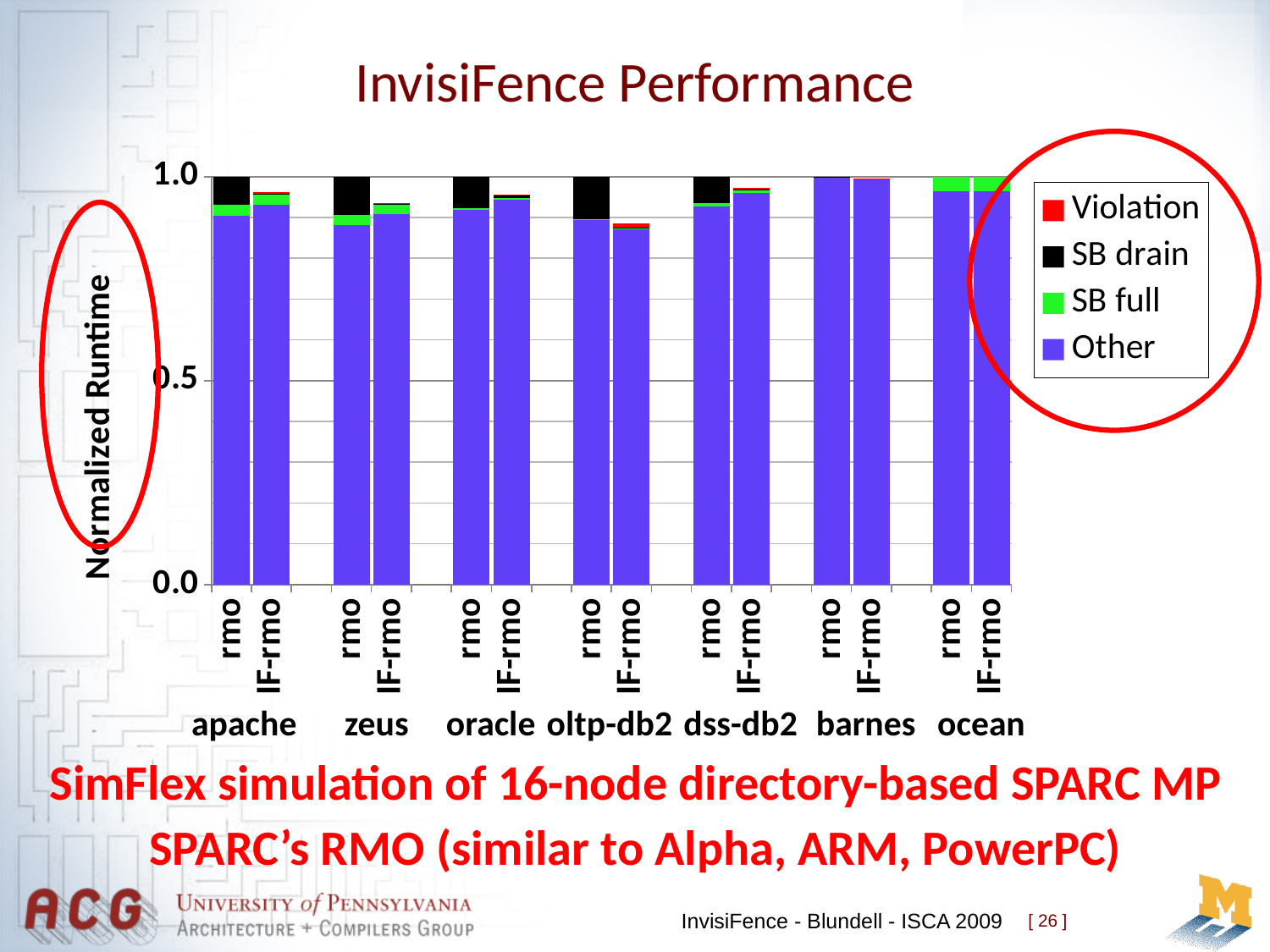
How many bars are plotted in total on the chart? 14 How many benchmark groups are shown along the x axis? 7 Is the IF-rmo bar for zeus greater or less than 0.5? greater Is the IF-rmo bar for oltp-db2 greater or less than 0.5? greater How many series does the legend list? 4 For zeus, which bar is taller, rmo or IF-rmo? rmo What is the label of the y axis? Normalized Runtime For oltp-db2, which bar is taller, rmo or IF-rmo? rmo What is the title of the chart? InvisiFence Performance Which legend entry is shown in red? Violation What type of chart is shown on the slide? bar chart Which benchmark has the lowest IF-rmo bar? oltp-db2